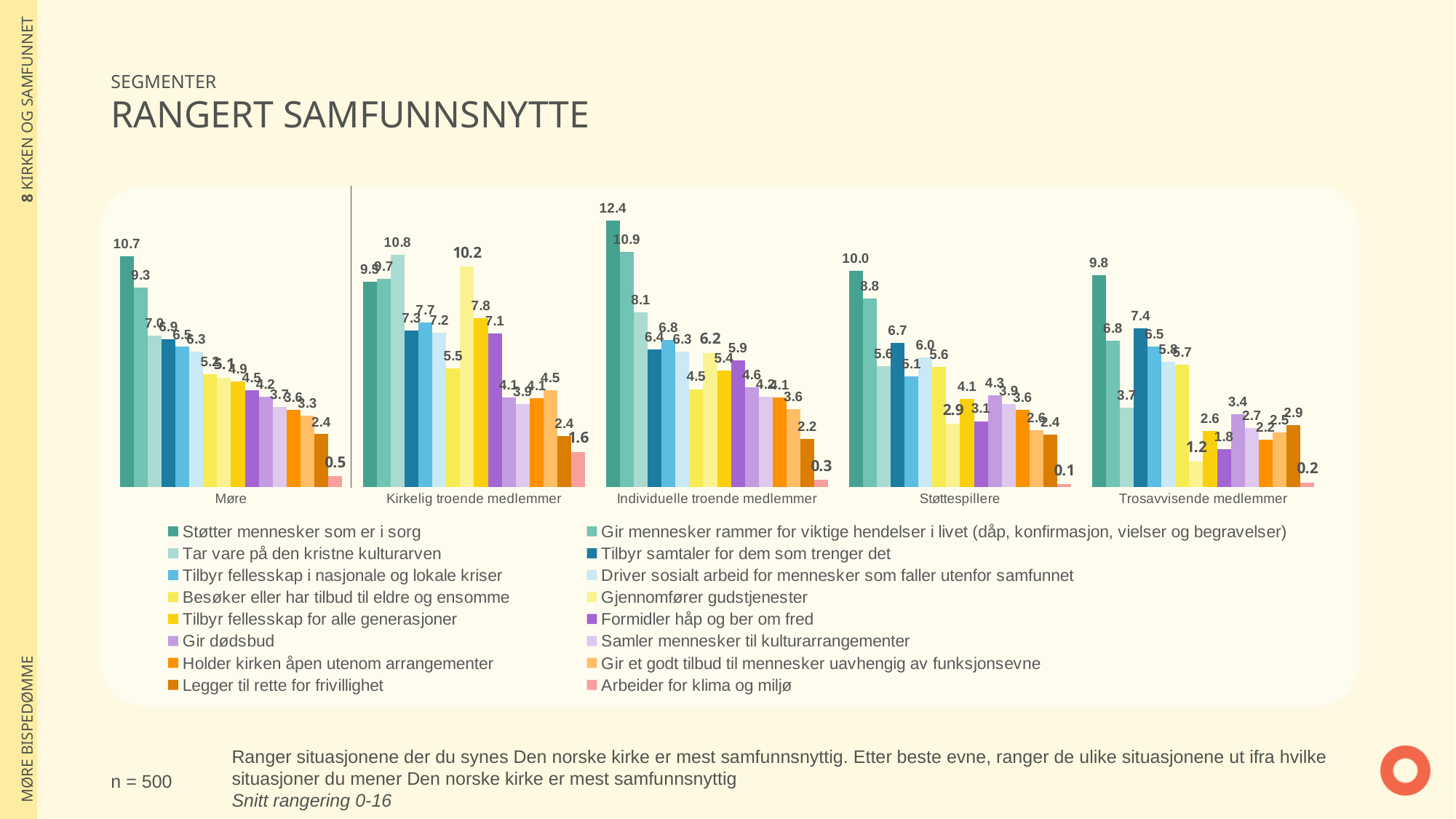
What is the value for 'Støtter mennesker som er i sorg' in the Møre group? 10.7 What is the value for 'Arbeider for klima og miljø' among Individuelle troende medlemmer? 0.3 How many segment groups are shown on the x axis of the chart? 5 What is the difference between the 'Støtter mennesker som er i sorg' values for Individuelle troende medlemmer and Møre? 1.7 How many series does the legend list? 16 For 'Tar vare på den kristne kulturarven', which segment has the larger value: Kirkelig troende medlemmer or Trosavvisende medlemmer? Kirkelig troende medlemmer What is the value for 'Legger til rette for frivillighet' in the Møre group? 2.4 What is the difference between the 'Arbeider for klima og miljø' values for Kirkelig troende medlemmer and Møre? 1.1 What kind of chart is shown on the slide? Bar chart Which segment has the highest value for 'Støtter mennesker som er i sorg'? Individuelle troende medlemmer Which segment has the lowest value for 'Arbeider for klima og miljø'? Støttespillere What is the value for 'Tilbyr samtaler for dem som trenger det' among Trosavvisende medlemmer? 7.4